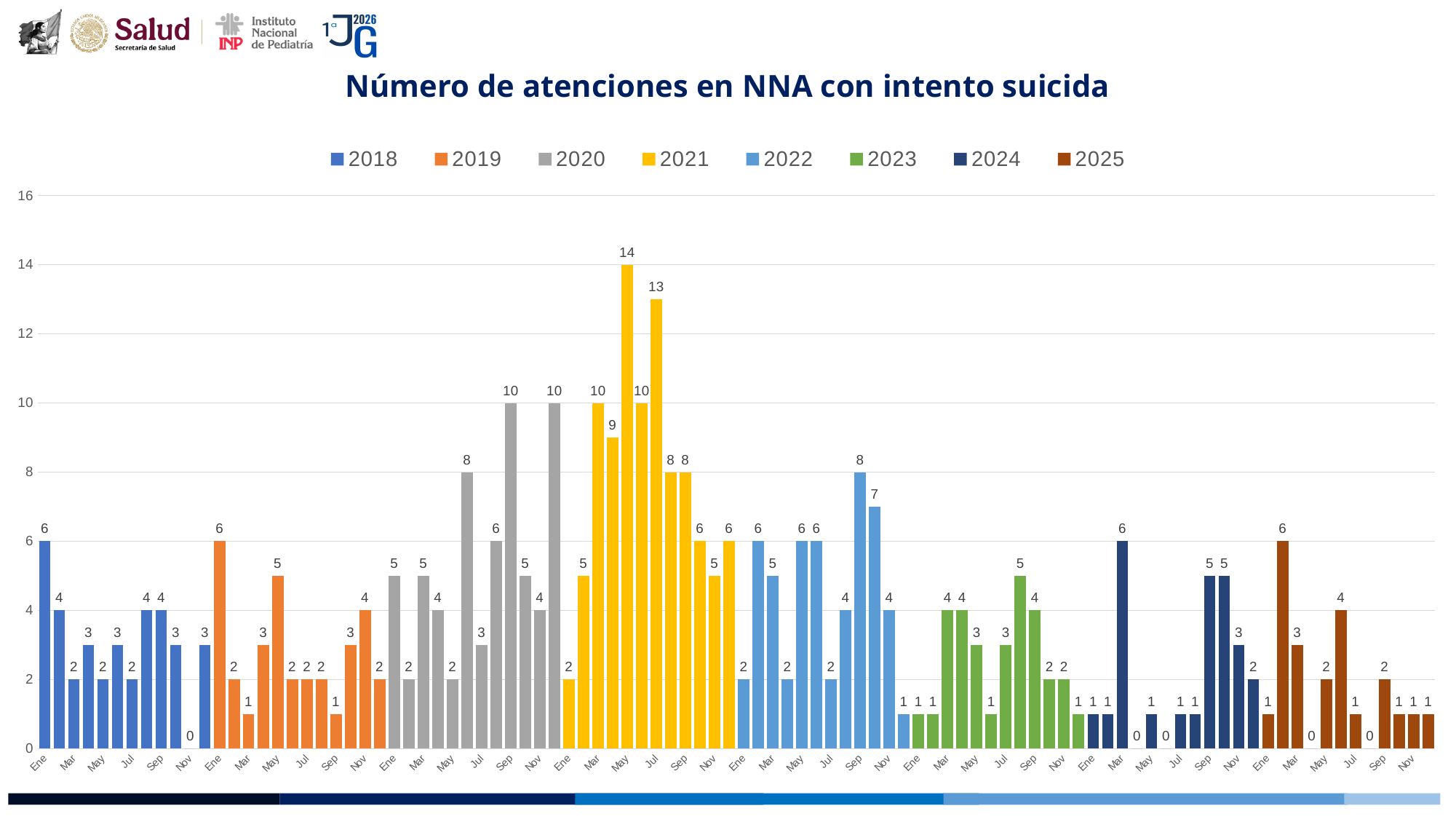
Which year's series is shown in green in the legend? 2023 What kind of chart is shown on the slide? bar chart What is the value for Nov 2018? 0 What is the title of the chart? Número de atenciones en NNA con intento suicida What is the difference between the value for May 2021 and the value for Jul 2021? 1 What is the value for Sep 2022? 8 What is the highest value shown in the chart, and in which month and year does it occur? 14, May 2021 What is the value for Jul 2021? 13 What is the value for Mar 2024? 6 How many series does the legend list? 8 What is the value for Sep 2020? 10 Which is larger, the value for Ene 2019 or the value for Ene 2020? Ene 2019